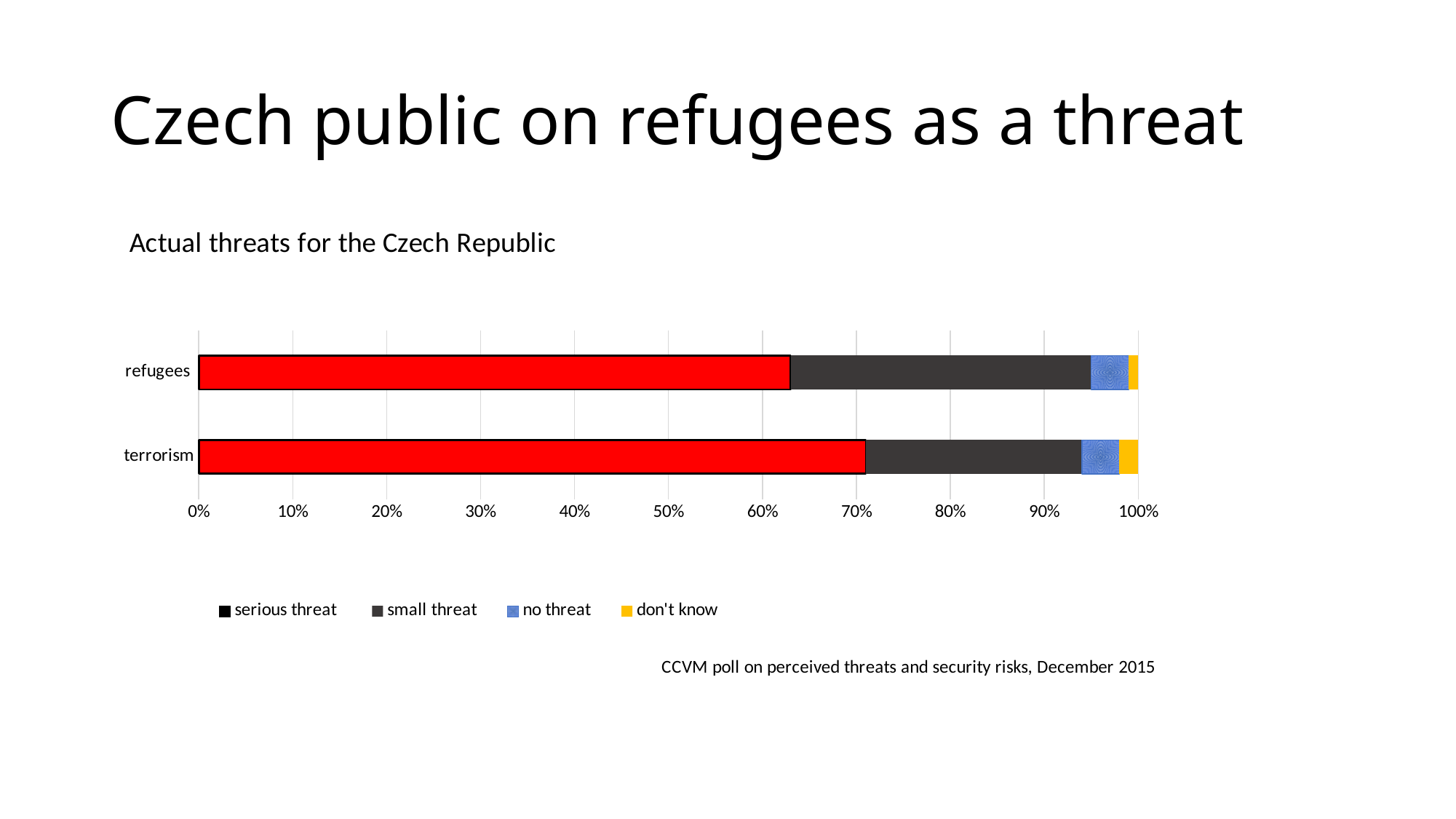
How many categories are plotted on the chart? 2 Which category has the larger 'small threat' share, refugees or terrorism? refugees What is the title of the chart? Actual threats for the Czech Republic What kind of chart is shown on the slide? stacked bar chart How many series does the legend list? 4 Which category has the larger 'serious threat' share, refugees or terrorism? terrorism Is the 'serious threat' value for refugees greater or less than 60%? greater Which series is shown in red on the chart? serious threat Is the 'serious threat' value for terrorism greater or less than 60%? greater Is the 'serious threat' value for terrorism greater or less than 80%? less Which category has the highest 'serious threat' share? terrorism